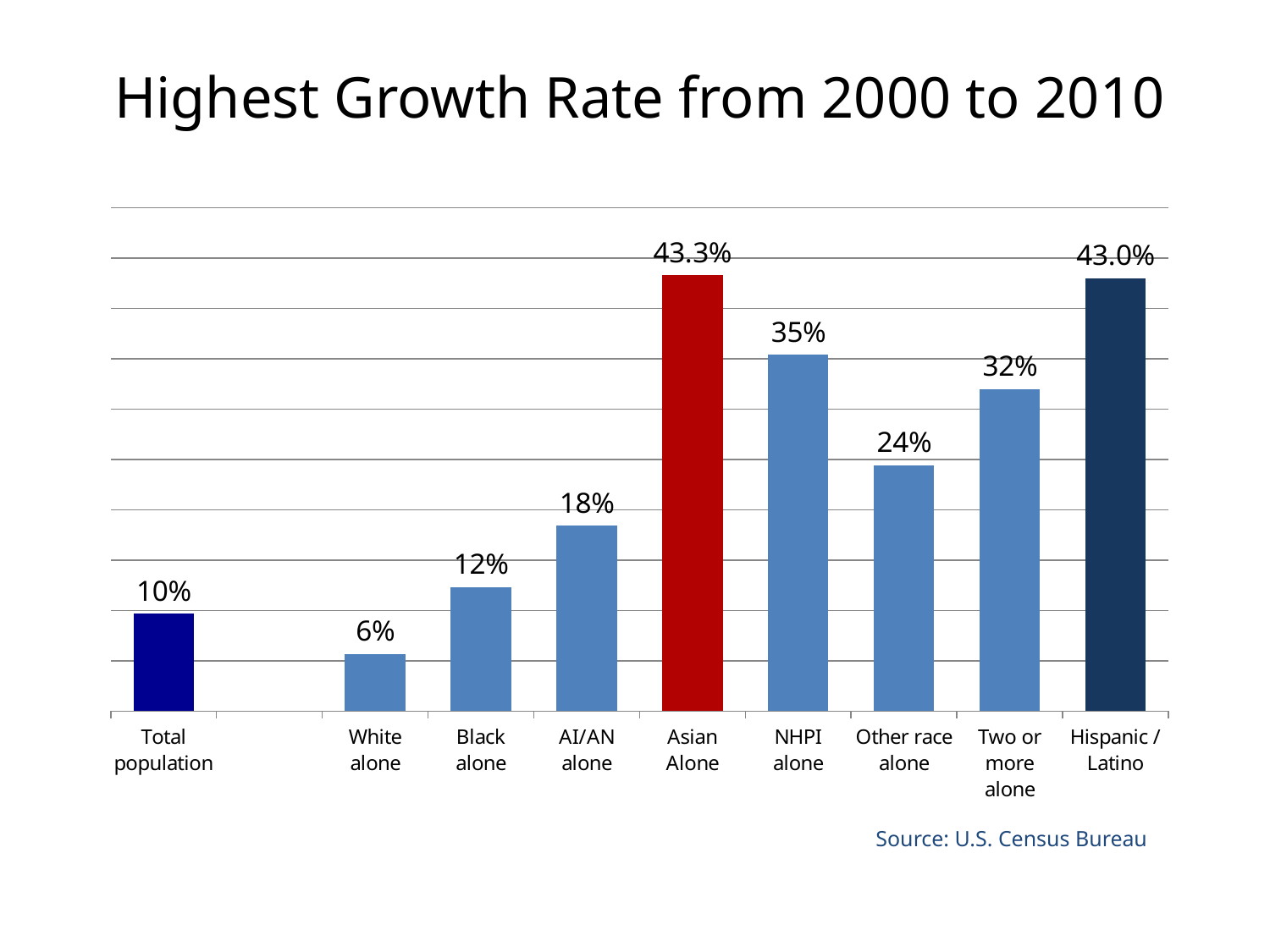
What is the growth rate shown for Hispanic / Latino? 43.0% What is the growth rate shown for Asian Alone? 43.3% What is the growth rate shown for NHPI alone? 35% Which category has the highest growth rate? Asian Alone What is the difference between the growth rates for NHPI alone and Black alone? 23% What is the title of the chart? Highest Growth Rate from 2000 to 2010 Which has a higher growth rate, AI/AN alone or Other race alone? Other race alone How many categories are shown on the chart? 9 Which category has the lowest growth rate? White alone What kind of chart is shown on the slide? Bar chart What is the difference between the growth rates for Two or more alone and Other race alone? 8% What is the growth rate shown for the Total population? 10%